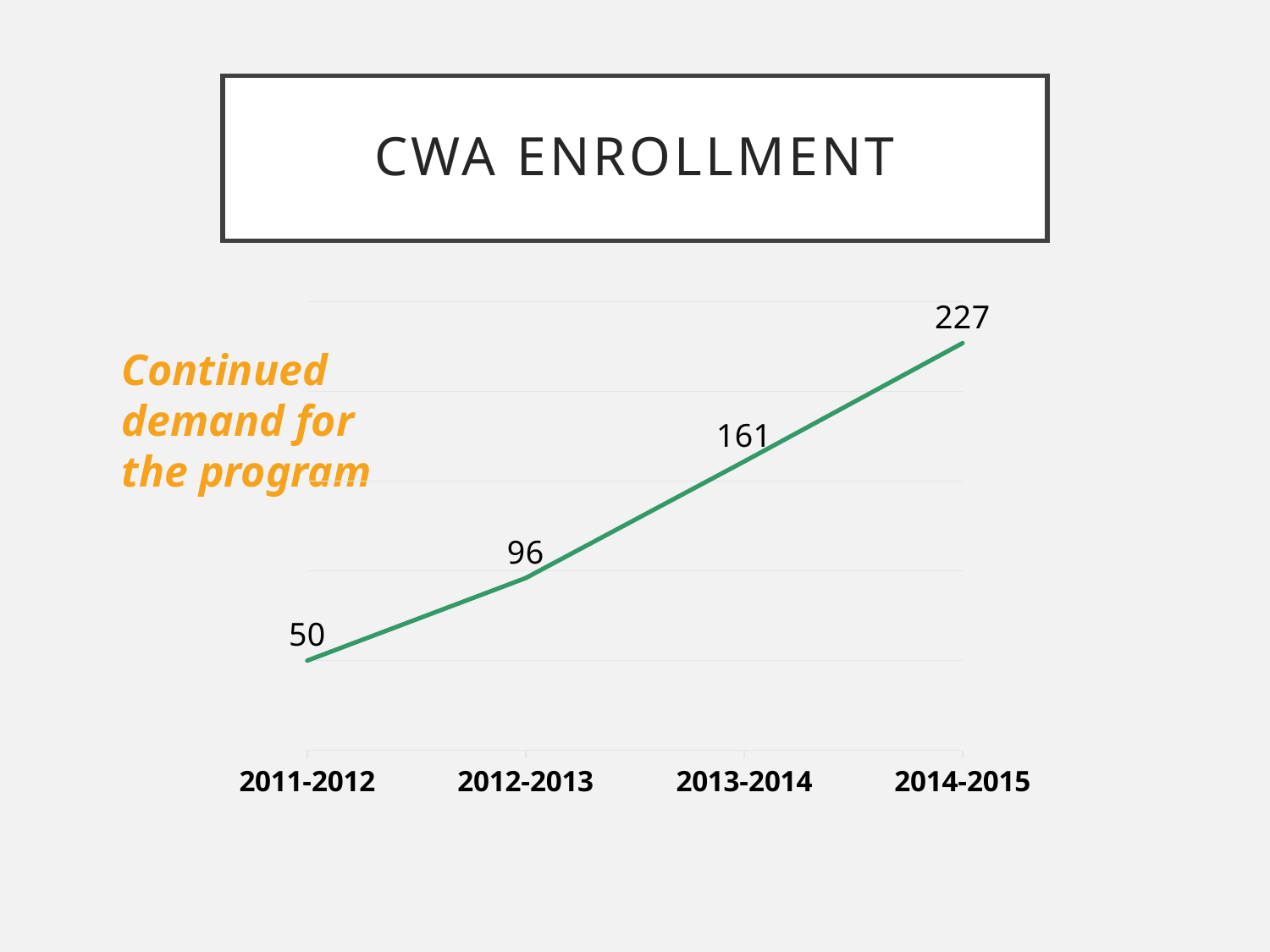
Which year has higher enrollment, 2012-2013 or 2013-2014? 2013-2014 What is the difference in enrollment between 2014-2015 and 2011-2012? 177 What is the difference in enrollment between 2013-2014 and 2012-2013? 65 How many academic years are plotted on the chart? 4 What is the CWA enrollment value for 2012-2013? 96 Which academic year has the lowest CWA enrollment? 2011-2012 What is the CWA enrollment value for 2011-2012? 50 Which academic year has the highest CWA enrollment? 2014-2015 What kind of chart is shown on the slide? Line chart What is the CWA enrollment value for 2014-2015? 227 What is the CWA enrollment value for 2013-2014? 161 Does CWA enrollment rise or fall from 2011-2012 to 2014-2015? Rise